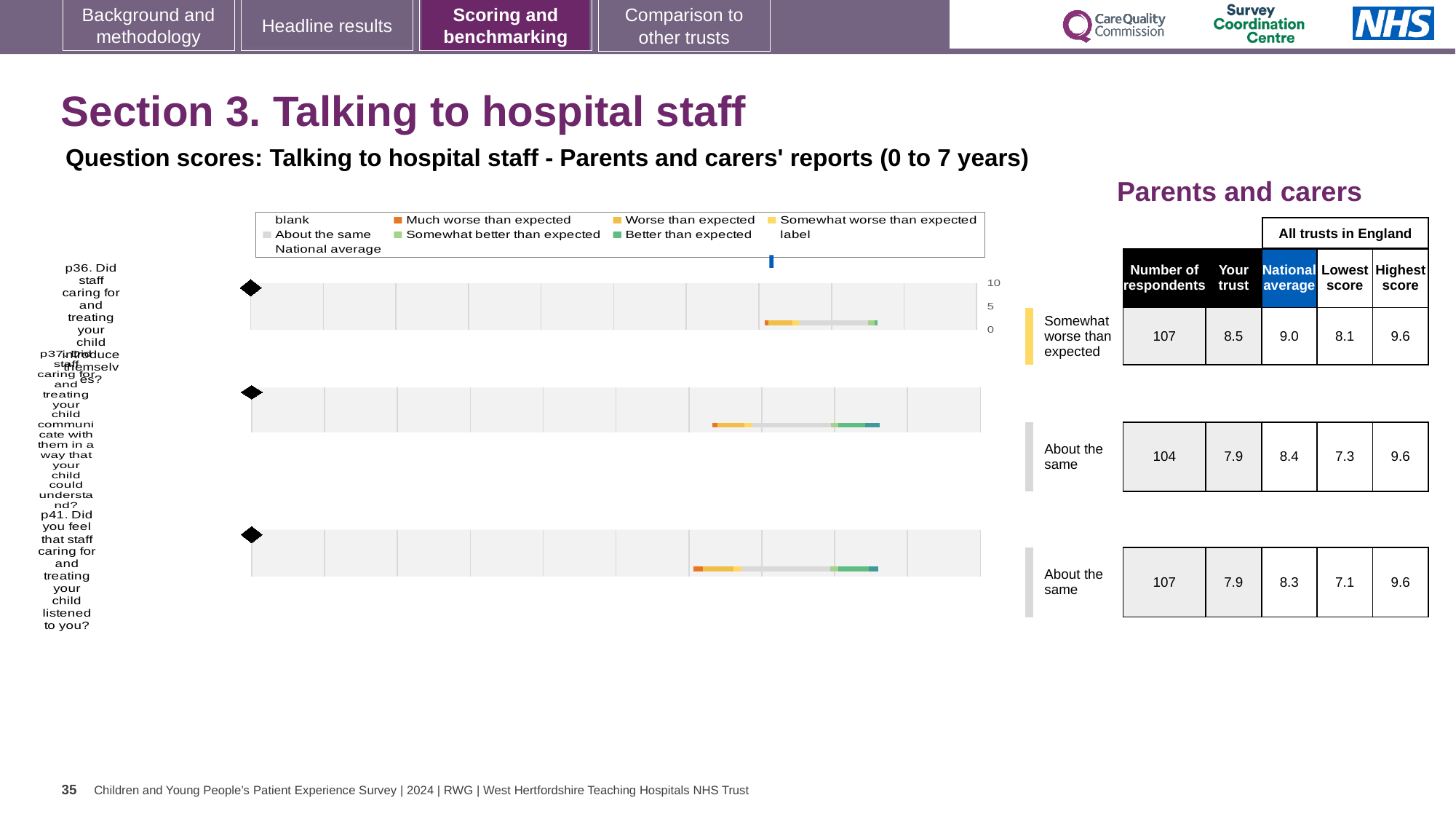
How many question charts (p36, p37, p41) are plotted on the slide? 3 What is the 'Your trust' score for p36 (Did staff caring for and treating your child introduce themselves)? 8.5 Which legend entry is shown in orange? Much worse than expected What is the national average score for p41 (Did you feel that staff caring for and treating your child listened to you)? 8.3 What is the highest value shown on the chart's numeric axis? 10 What kind of chart is used to show the benchmark ranges for each question on this slide? bar chart What is the difference between the national average and the 'Your trust' score for p36? 0.5 How many respondents answered p37? 104 Is the 'Your trust' score for p37 higher or lower than the national average for p37? lower Which question has the lowest 'Lowest score' across all trusts in England? p41 Which question has the highest 'Your trust' score? p36 Is the national average for p36 greater or less than 5 on the chart axis? greater